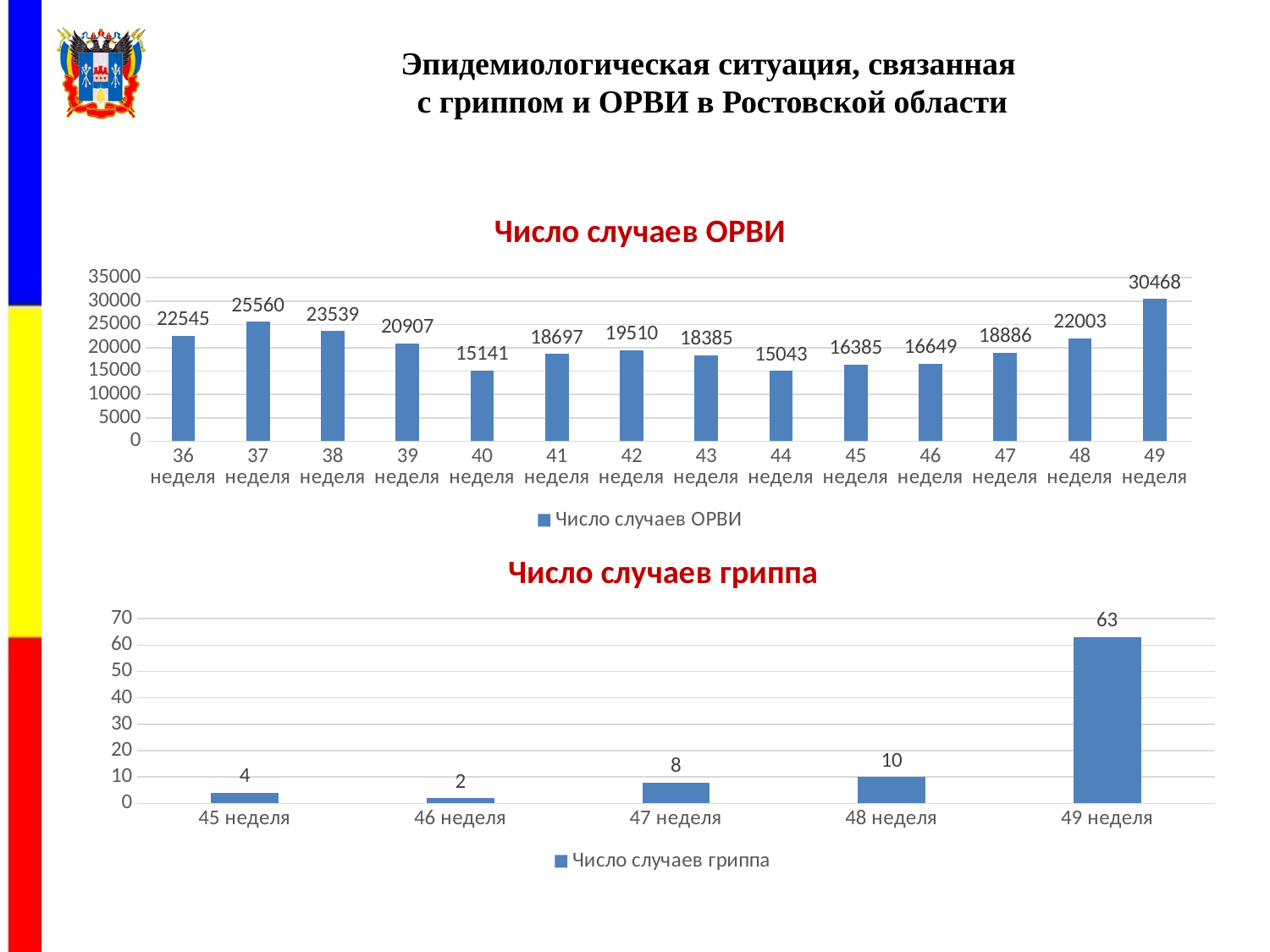
How many series does the legend of the chart 'Число случаев ОРВИ' list? 1 In the chart 'Число случаев ОРВИ', which is larger: the value for 37 неделя or 38 неделя? 37 неделя In the chart 'Число случаев ОРВИ', which week has the highest value? 49 неделя In the chart 'Число случаев гриппа', which week has the lowest value? 46 неделя In the chart 'Число случаев гриппа', what is the difference between the values for 49 неделя and 47 неделя? 55 In the chart 'Число случаев гриппа', how many weeks are shown? 5 In the chart 'Число случаев ОРВИ', how many weeks are shown? 14 In the chart 'Число случаев гриппа', what is the value for 48 неделя? 10 In the chart 'Число случаев ОРВИ', what is the value for 40 неделя? 15141 What kind of chart is 'Число случаев гриппа'? bar chart In the chart 'Число случаев ОРВИ', which week has the lowest value? 44 неделя In the chart 'Число случаев ОРВИ', what is the difference between the values for 49 неделя and 48 неделя? 8465